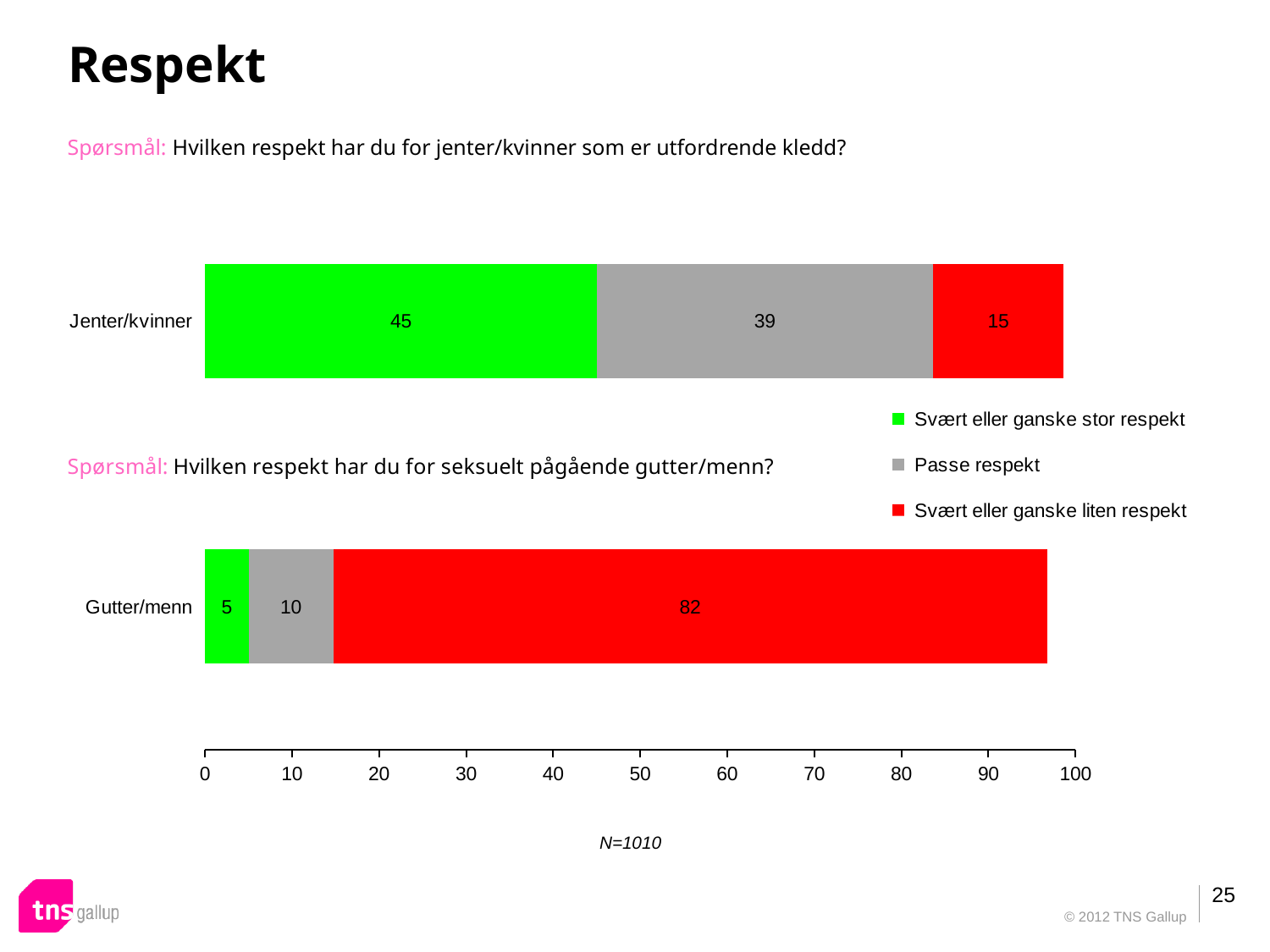
How many series does the legend list? 3 What is the value for "Svært eller ganske liten respekt" for Jenter/kvinner? 15 What is the value for "Svært eller ganske stor respekt" for Jenter/kvinner? 45 What is the difference between the "Svært eller ganske liten respekt" values for Gutter/menn and Jenter/kvinner? 67 What kind of chart is shown on the slide? Stacked bar chart Which segment is the largest in the Gutter/menn bar? Svært eller ganske liten respekt Which segment is the smallest in the Jenter/kvinner bar? Svært eller ganske liten respekt How many categories (bars) are shown in the chart? 2 What is the value for "Svært eller ganske liten respekt" for Gutter/menn? 82 What is the total of the stacked bar for Jenter/kvinner? 99 What is the value for "Passe respekt" for Gutter/menn? 10 Which is larger: "Passe respekt" for Jenter/kvinner or "Passe respekt" for Gutter/menn? Jenter/kvinner